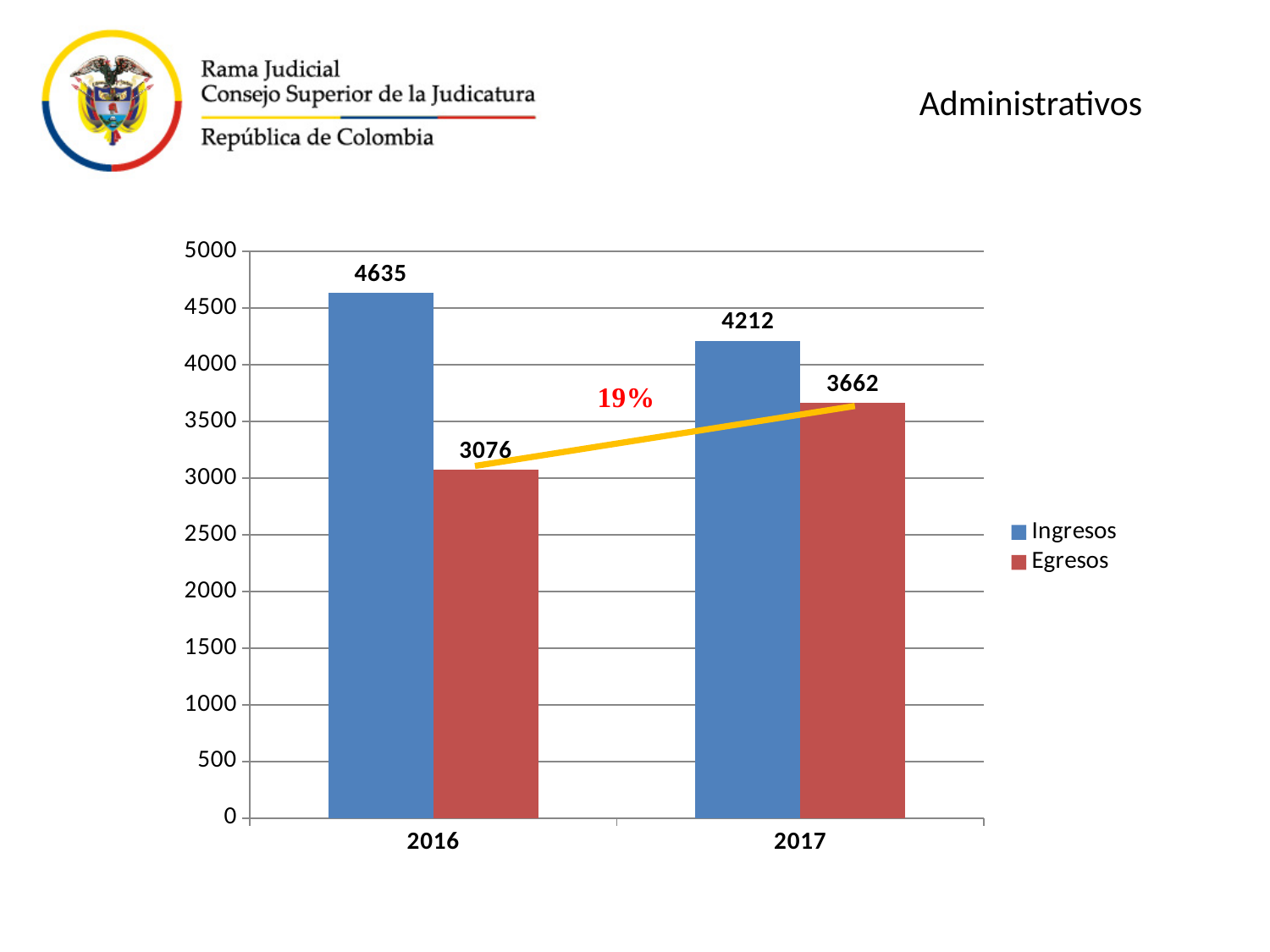
Which year has the lowest Egresos value? 2016 What is the value of Ingresos for 2017? 4212 What is the difference between Egresos in 2017 and Egresos in 2016? 586 What is the difference between Ingresos and Egresos in 2016? 1559 What kind of chart is shown on the slide? Bar chart Which is larger in 2017, Ingresos or Egresos? Ingresos How many series does the legend list? 2 What is the value of Egresos for 2017? 3662 What percentage is written in red above the yellow line on the chart? 19% What is the value of Ingresos for 2016? 4635 What is the value of Egresos for 2016? 3076 Which year has the highest Ingresos value? 2016